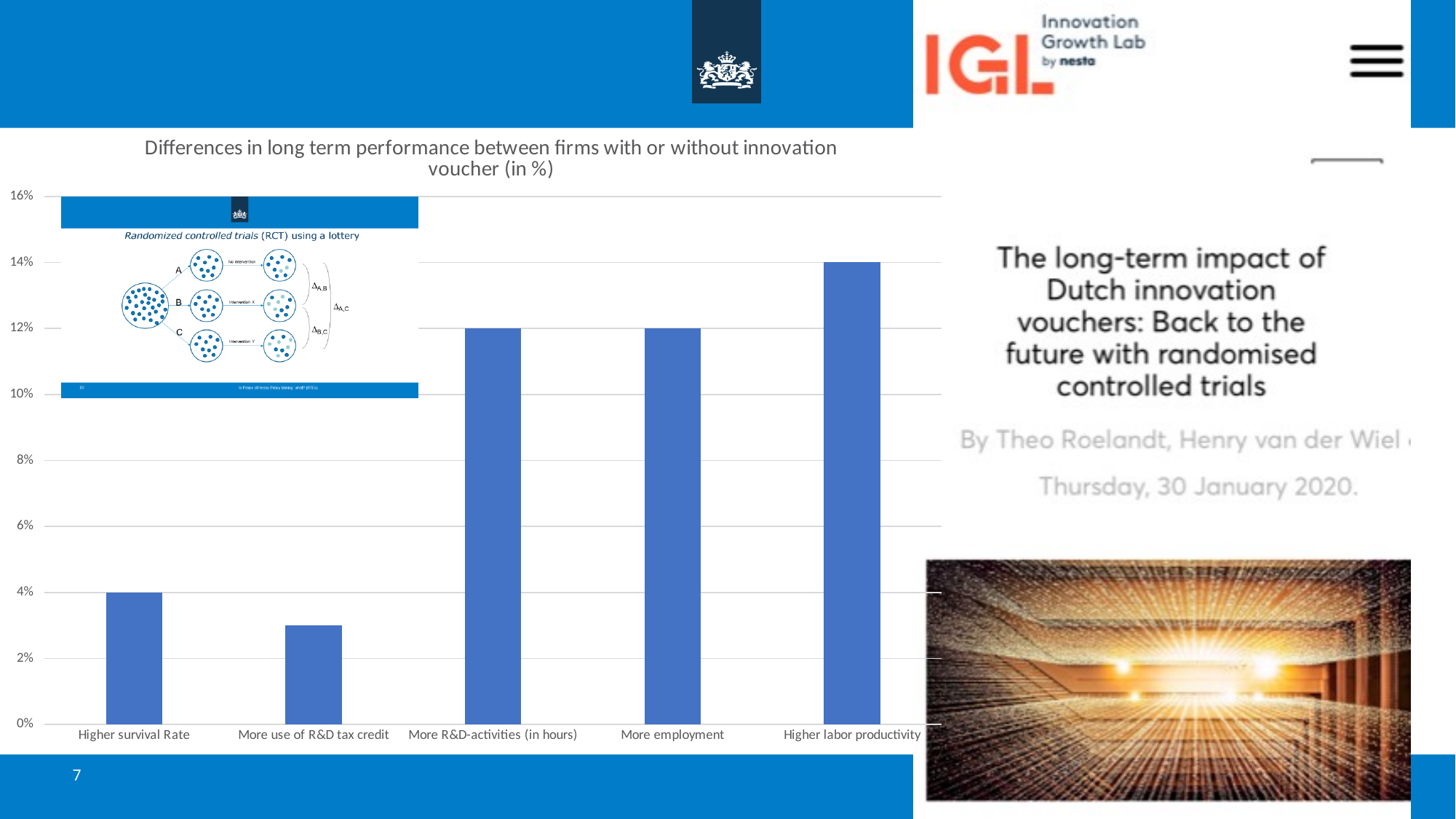
Which category has the highest value in the chart? Higher labor productivity Which category has the lowest value in the chart? More use of R&D tax credit Is the value for More use of R&D tax credit greater or less than 4%? less What is the title of the chart? Differences in long term performance between firms with or without innovation voucher (in %) What is the value for Higher survival Rate? 4% How many categories are shown on the x axis of the chart? 5 Is the value for Higher labor productivity greater or less than 12%? greater Which is larger, the value for More employment or the value for Higher survival Rate? More employment What is the value for Higher labor productivity? 14% What is the value for More employment? 12% What type of chart is shown on the slide? Bar chart What is the difference between the values for Higher labor productivity and More R&D-activities (in hours)? 2%